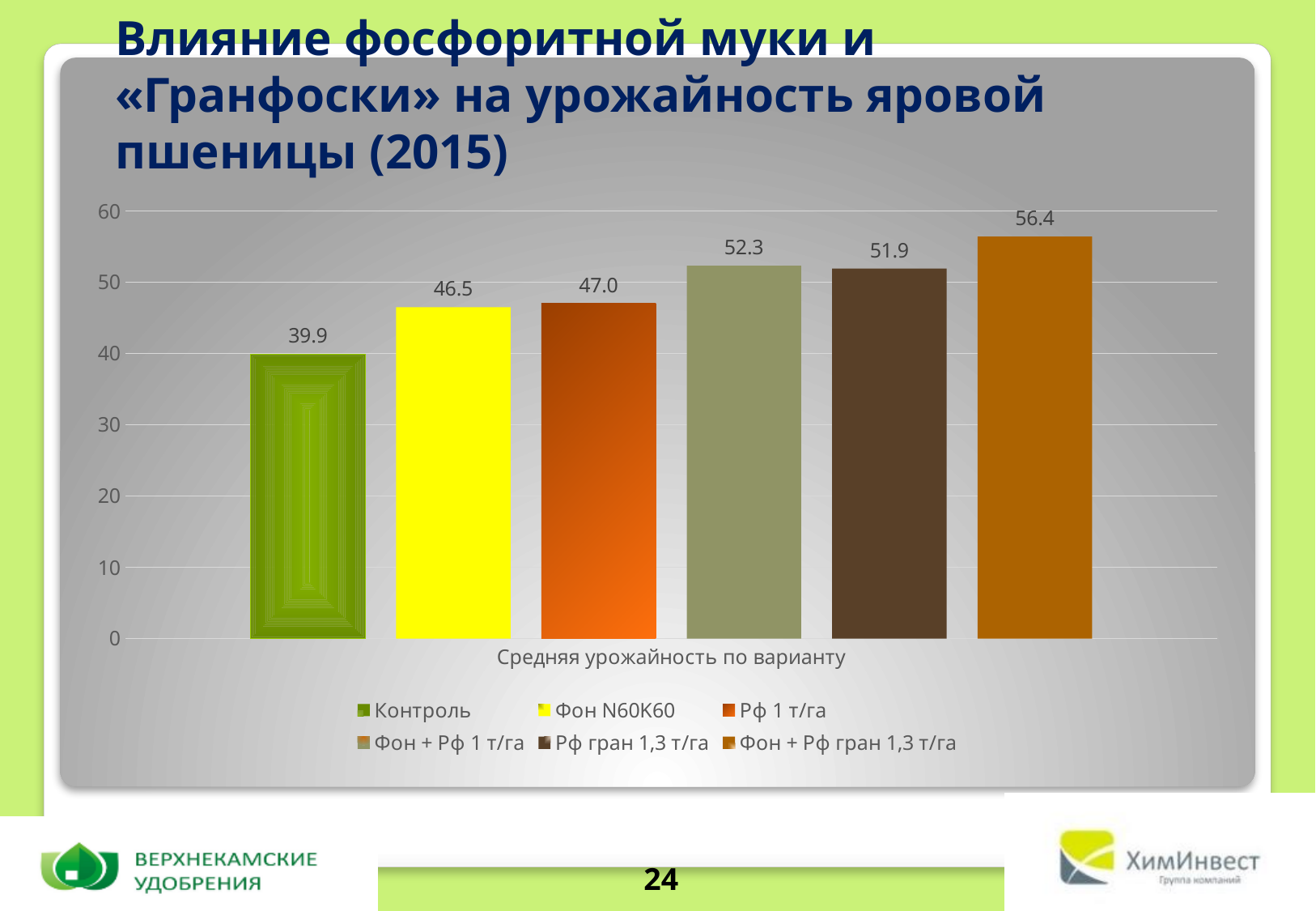
What is the value for Рф гран 1,3 т/га? 51.9 Which series has the highest value? Фон + Рф гран 1,3 т/га What is the value for Фон + Рф гран 1,3 т/га? 56.4 What is the value for Контроль? 39.9 Which series has the lowest value? Контроль Is the value for Контроль greater or less than 40? less What is the difference between Фон + Рф гран 1,3 т/га and Контроль? 16.5 What is the difference between Фон + Рф 1 т/га and Фон N60K60? 5.8 Which is larger, Рф 1 т/га or Фон N60K60? Рф 1 т/га How many series does the legend list? 6 What is the value for Фон N60K60? 46.5 What kind of chart is shown on the slide? bar chart